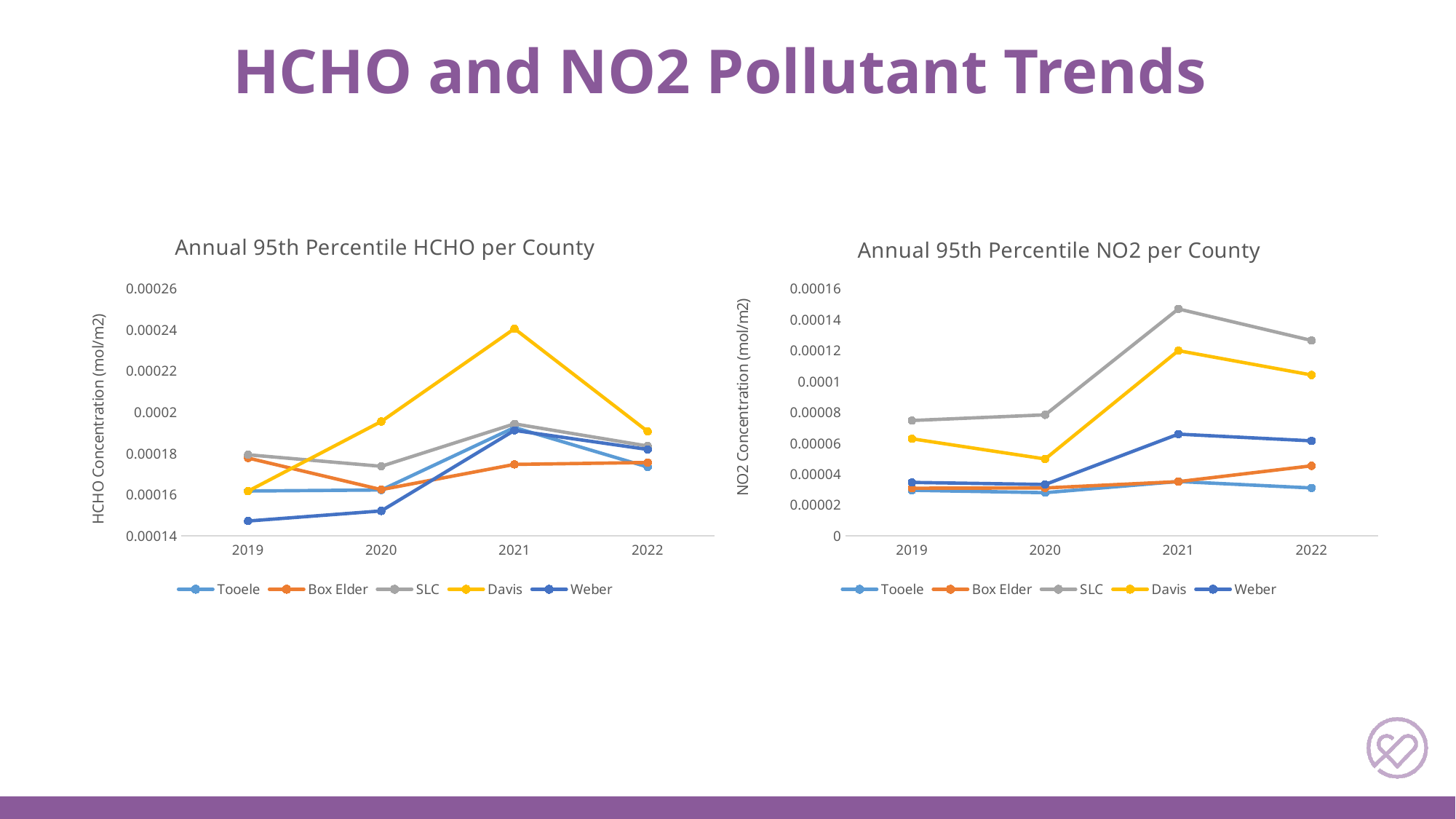
In the "Annual 95th Percentile NO2 per County" chart, which is larger in 2022, the value for Davis or the value for Weber? Davis In the "Annual 95th Percentile HCHO per County" chart, is the value for Weber in 2019 greater or less than 0.00016? less How many series does the legend of the "Annual 95th Percentile NO2 per County" chart list? 5 How many years are shown on the x axis of the "Annual 95th Percentile HCHO per County" chart? 4 In the "Annual 95th Percentile HCHO per County" chart, which county has the lowest value in 2019? Weber In the "Annual 95th Percentile HCHO per County" chart, is the value for Davis in 2021 greater or less than 0.00022? greater In the "Annual 95th Percentile NO2 per County" chart, does the SLC line rise or fall from 2021 to 2022? fall In the "Annual 95th Percentile HCHO per County" chart, which county has the highest value in 2021? Davis In the "Annual 95th Percentile NO2 per County" chart, is the value for SLC in 2021 greater or less than 0.00014? greater What kind of chart is the "Annual 95th Percentile HCHO per County" chart? line chart What is the y-axis label of the "Annual 95th Percentile NO2 per County" chart? NO2 Concentration (mol/m2) In the "Annual 95th Percentile NO2 per County" chart, which county has the highest value in 2021? SLC